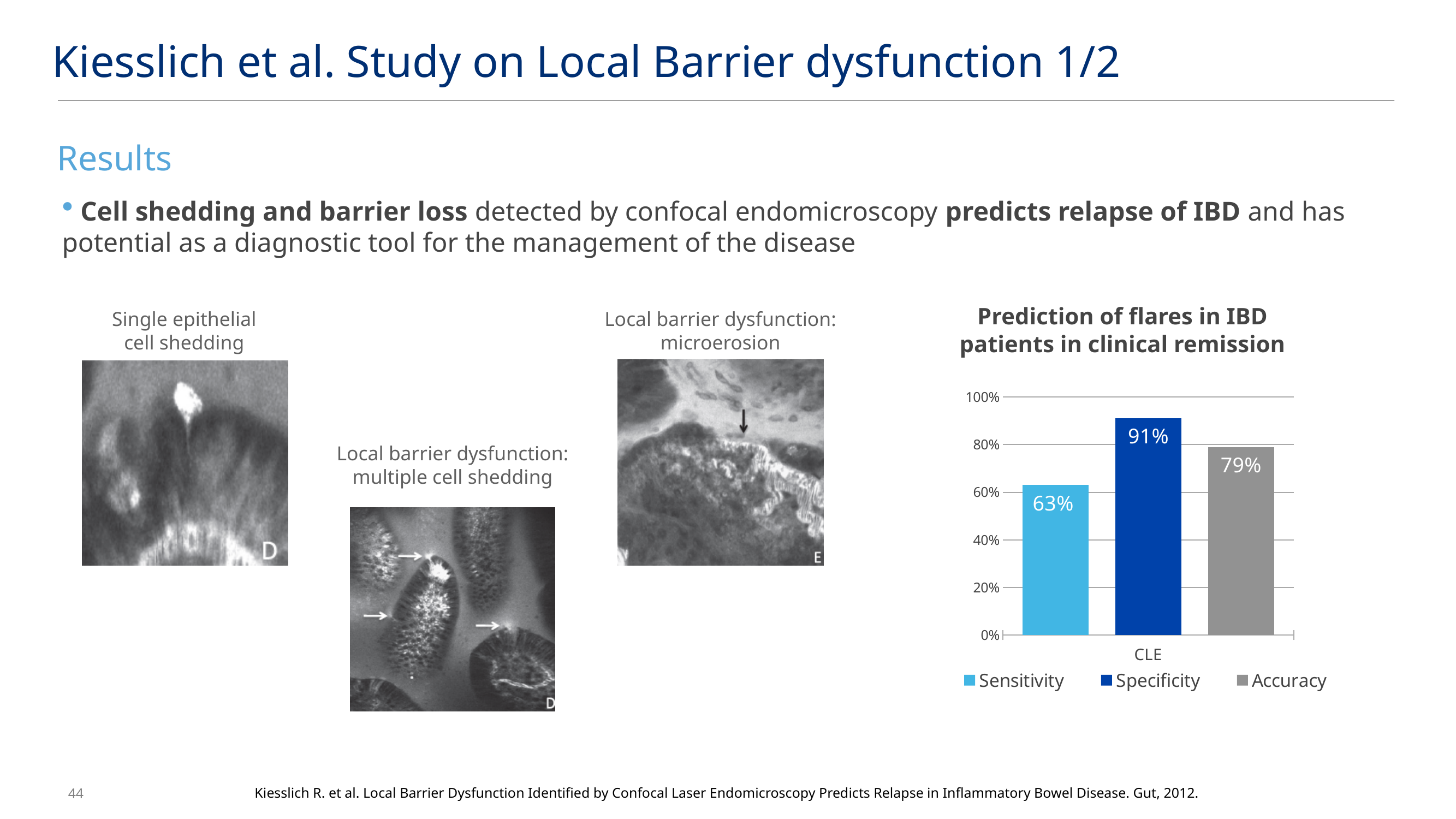
How many series does the chart legend list? 3 What is the title of the chart? Prediction of flares in IBD patients in clinical remission What kind of chart is shown on the slide? bar chart Is the Sensitivity value for CLE greater or less than 80%? less Which is larger for CLE, Accuracy or Sensitivity? Accuracy What is the Accuracy value for CLE in the chart? 79% What is the difference between the Specificity and Accuracy values for CLE? 12% Which series has the lowest value for CLE? Sensitivity What is the Sensitivity value for CLE in the chart? 63% What is the difference between the Specificity and Sensitivity values for CLE? 28% Which series has the highest value for CLE? Specificity What is the Specificity value for CLE in the chart? 91%